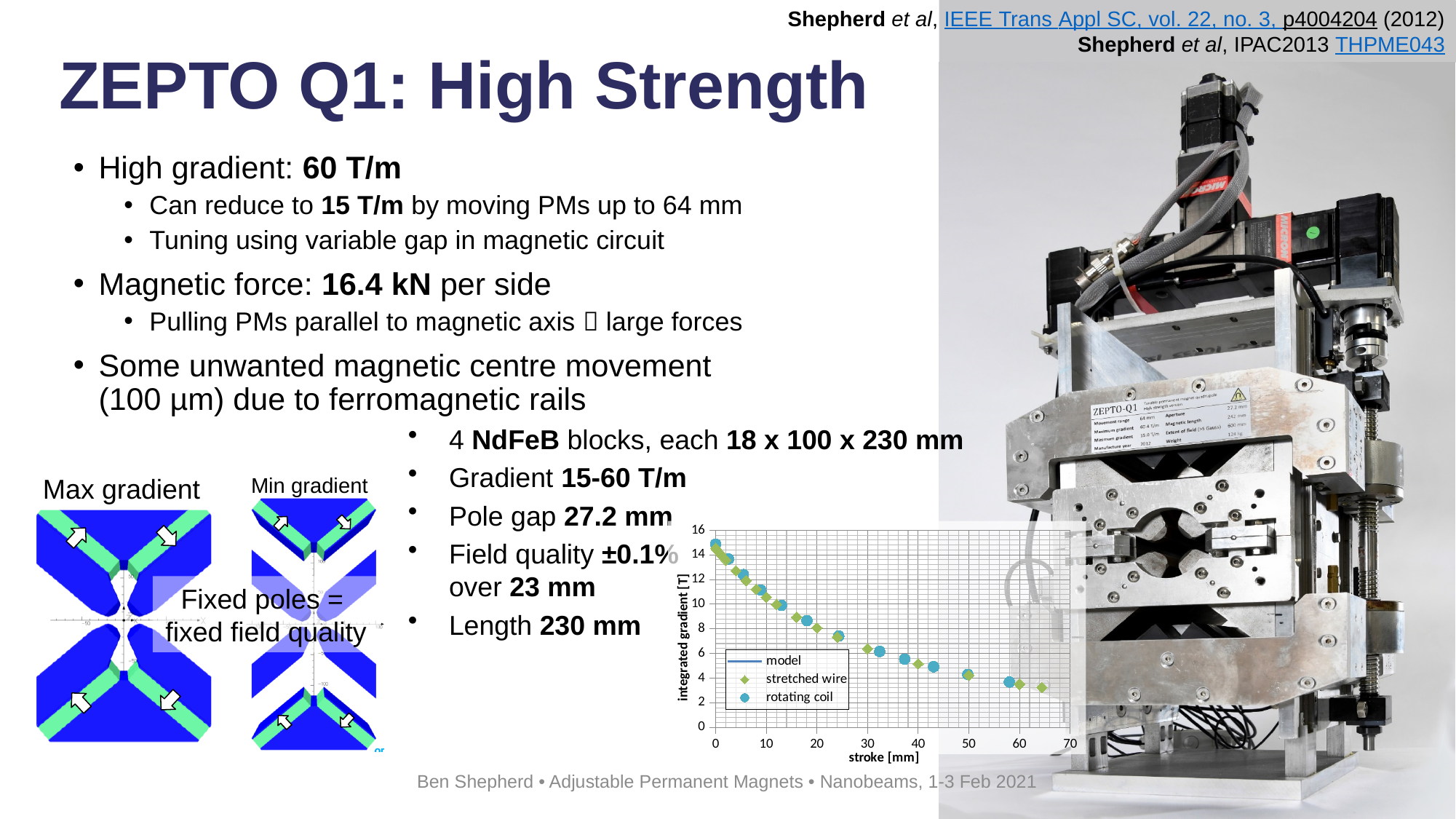
What is the maximum value shown on the y axis of the chart? 16 Which has the larger integrated gradient: the point at stroke 0 mm or the point at stroke 65 mm? stroke 0 mm Does the integrated gradient rise or fall as the stroke increases? fall Is the integrated gradient at a stroke of 50 mm greater or less than 6 T? less How many series does the legend of the chart list? 3 Is the integrated gradient at a stroke of 10 mm greater or less than 8 T? greater What kind of chart is shown at the bottom of the slide? scatter chart Is the integrated gradient at a stroke of 30 mm greater or less than 8 T? less What are the three series named in the chart legend? model, stretched wire, rotating coil What is the label of the x axis of the chart? stroke [mm]